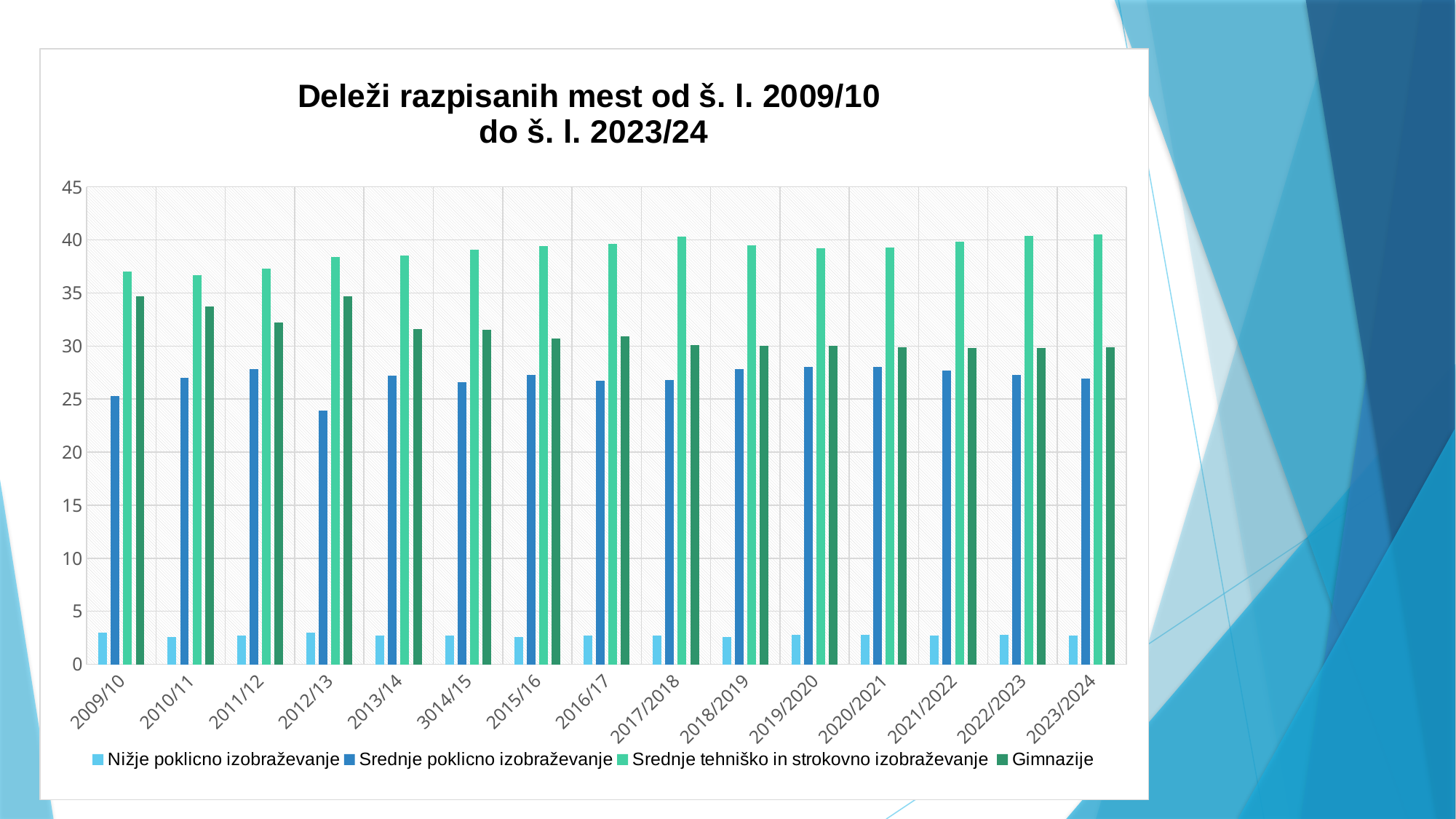
Which series has the highest value in 2009/10? Srednje tehniško in strokovno izobraževanje How many school years are shown on the x axis? 15 Does the value for Gimnazije rise or fall overall from 2009/10 to 2023/2024? fall Is the value for Nižje poklicno izobraževanje in 2015/16 greater or less than 5? less Which series has the lowest value in 2023/2024? Nižje poklicno izobraževanje Is the value for Srednje poklicno izobraževanje in 2012/13 greater or less than 25? less How many series does the legend list? 4 Is the value for Srednje tehniško in strokovno izobraževanje in 2009/10 greater or less than 35? greater Which is larger for Gimnazije: the value in 2009/10 or the value in 2023/2024? 2009/10 What kind of chart is shown on the slide? bar chart In which school year is the value for Srednje poklicno izobraževanje lowest? 2012/13